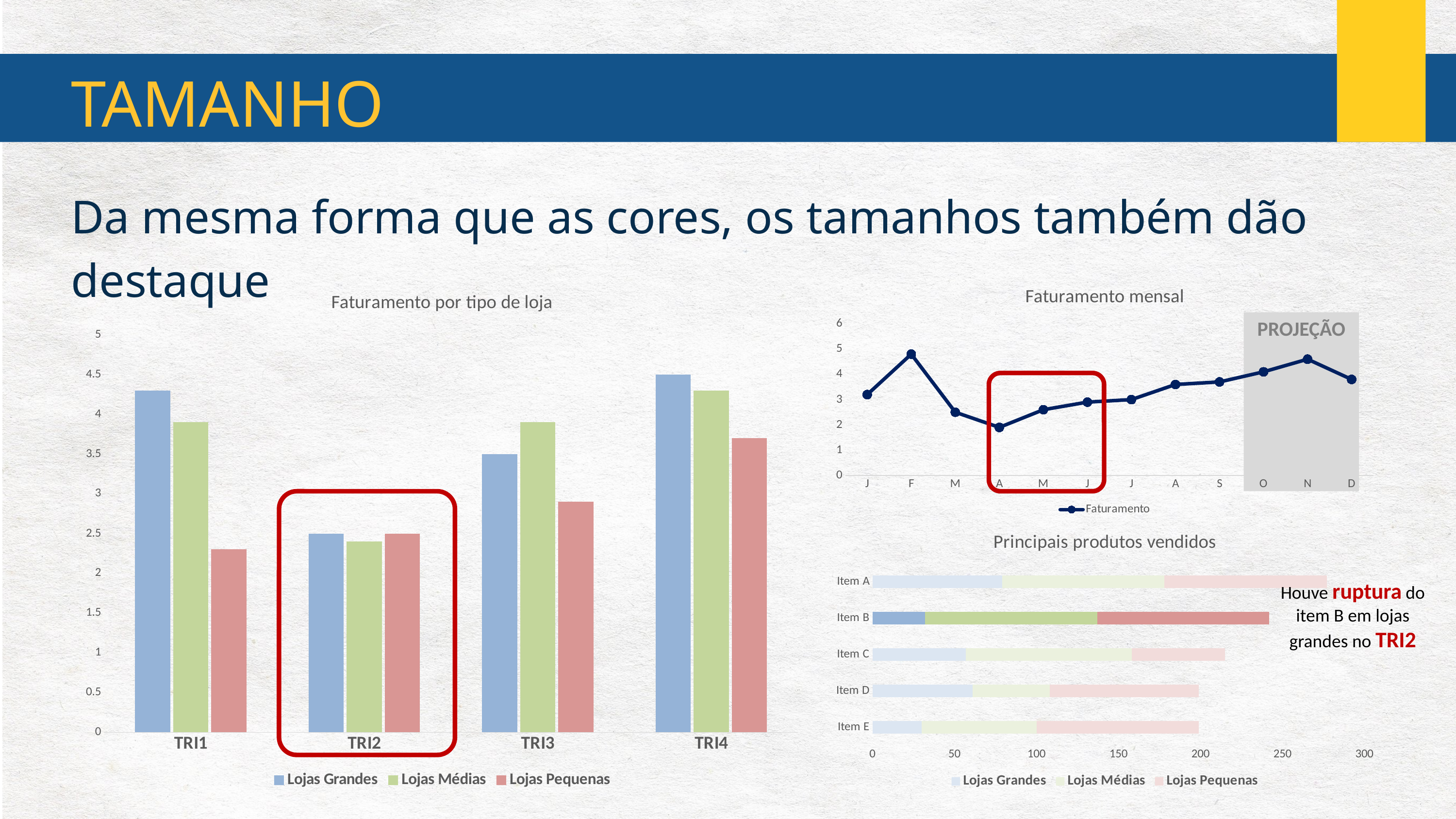
In the 'Faturamento por tipo de loja' chart, in which quarter is Lojas Pequenas highest? TRI4 In the 'Faturamento por tipo de loja' chart, is the value for Lojas Grandes in TRI1 greater or less than 4? greater In the 'Principais produtos vendidos' chart, how many items are listed? 5 In the 'Faturamento por tipo de loja' chart, how many categories are shown on the x axis? 4 In the 'Faturamento mensal' chart, do the values rise or fall from A to J? rise In the 'Faturamento mensal' chart, which month has the lowest value? A In the 'Faturamento por tipo de loja' chart, what kind of chart is it? bar chart In the 'Faturamento por tipo de loja' chart, how many series does the legend list? 3 In the 'Faturamento por tipo de loja' chart, in TRI3, which is larger: Lojas Grandes or Lojas Médias? Lojas Médias In the 'Faturamento mensal' chart, is the value for F greater or less than 4? greater In the 'Faturamento por tipo de loja' chart, in which quarter is Lojas Médias lowest? TRI2 In the 'Faturamento por tipo de loja' chart, is the value for Lojas Pequenas in TRI1 greater or less than 3? less